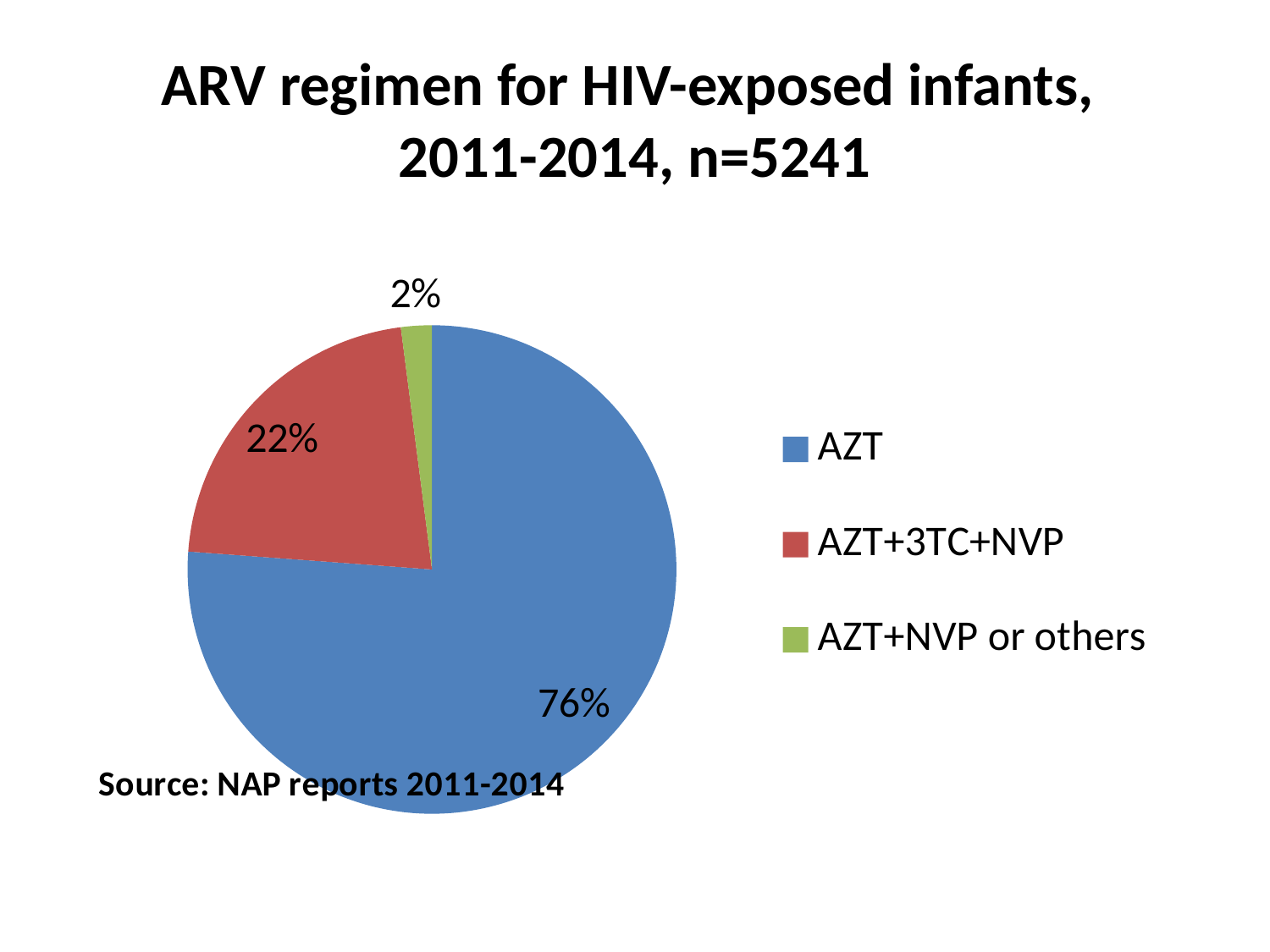
How many slices does the pie chart have? 3 Which regimen has the largest slice of the pie? AZT What is the difference in percentage points between the AZT slice and the AZT+3TC+NVP slice? 54 What colour is the slice for AZT+3TC+NVP? Red What share of the pie does AZT account for? 76% What share of the pie does AZT+NVP or others account for? 2% Which is larger, the AZT+3TC+NVP slice or the AZT+NVP or others slice? AZT+3TC+NVP What kind of chart is shown on the slide? Pie chart What share of the pie does AZT+3TC+NVP account for? 22% What is the difference in percentage points between the AZT+3TC+NVP slice and the AZT+NVP or others slice? 20 Which regimen has the smallest slice of the pie? AZT+NVP or others What is the title of the chart? ARV regimen for HIV-exposed infants, 2011-2014, n=5241